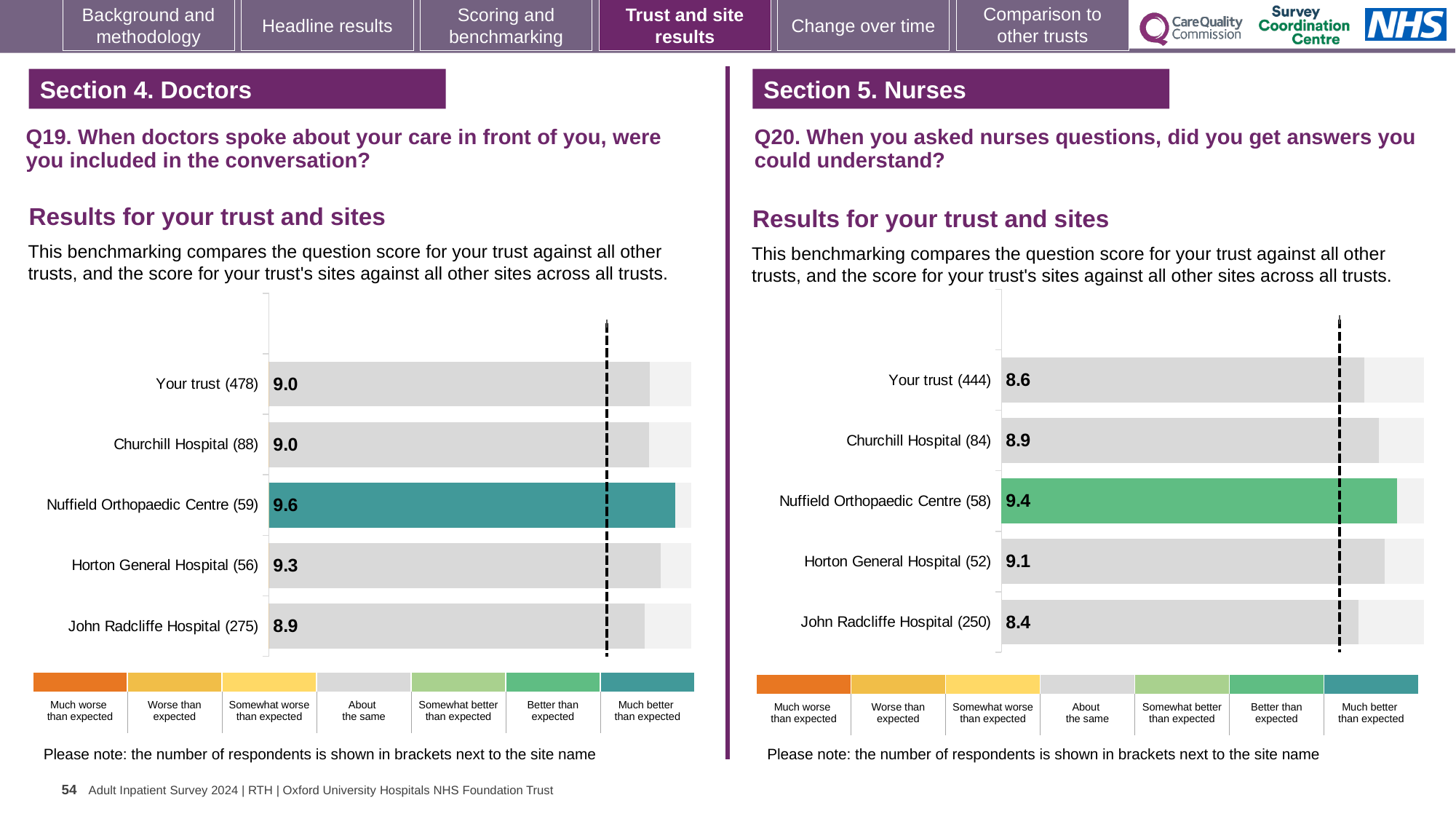
In the Q20 chart on the right, which has the higher score, Horton General Hospital or Your trust? Horton General Hospital In the Q20 chart on the right, what is the difference between the scores for Churchill Hospital and John Radcliffe Hospital? 0.5 In the Q20 chart on the right, which benchmark category does the green colour of the Nuffield Orthopaedic Centre bar represent? Better than expected In the Q20 chart on the right, which site has the lowest score? John Radcliffe Hospital In the Q19 chart on the left, what is the difference between the scores for Nuffield Orthopaedic Centre and Horton General Hospital? 0.3 What type of chart is used for the Q20 results on the right? Bar chart In the Q19 chart on the left, which site has the lowest score? John Radcliffe Hospital In the Q20 chart on the right, what is the score for Your trust? 8.6 In the Q20 chart on the right, which site has the highest score? Nuffield Orthopaedic Centre How many bars are shown in the Q19 chart on the left? 5 In the Q19 chart on the left, what is the score for Nuffield Orthopaedic Centre? 9.6 In the Q19 chart on the left, what is the score for John Radcliffe Hospital? 8.9